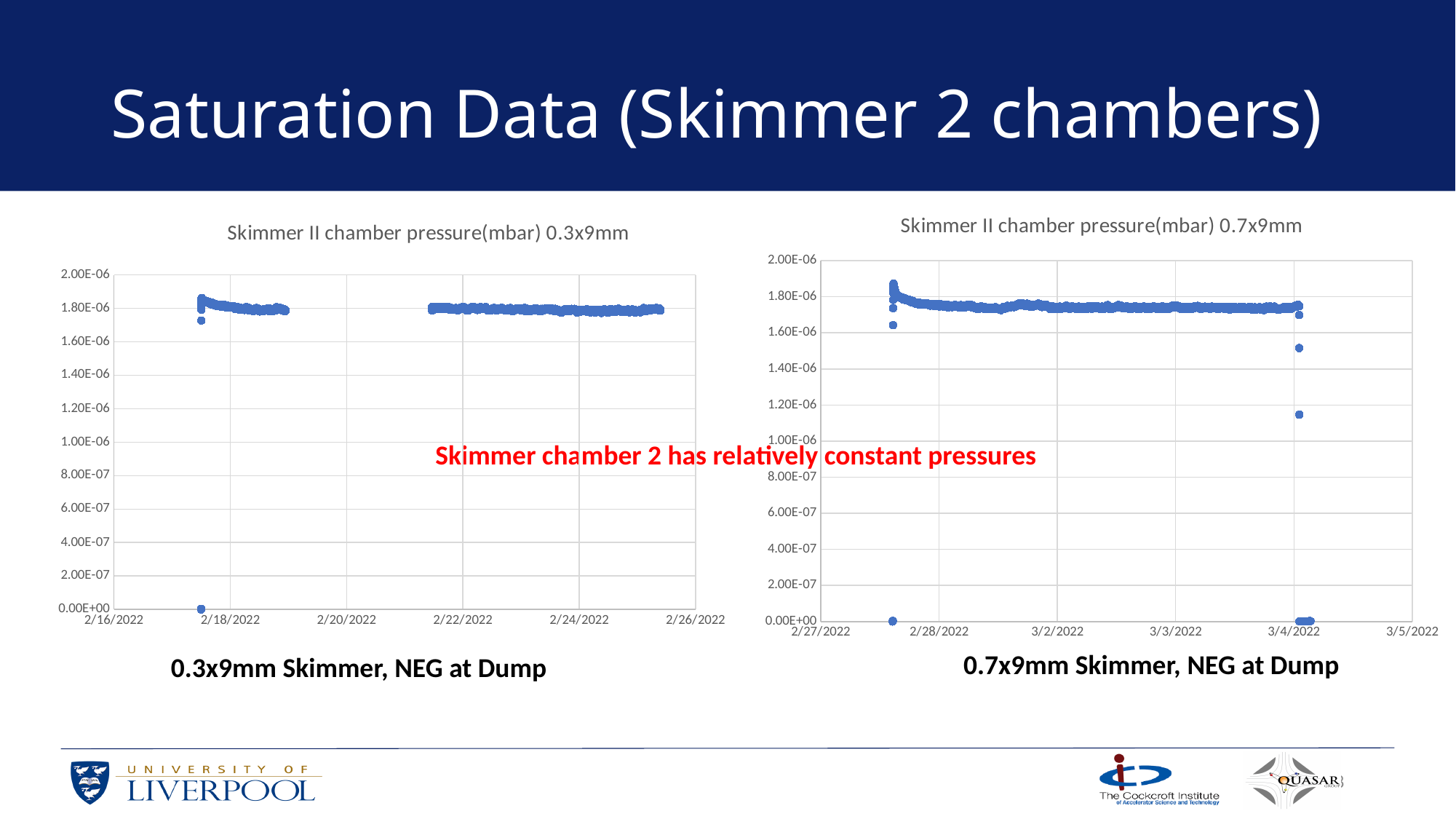
What is the first date label on the x axis of the right chart (0.7x9mm)? 2/27/2022 In the right chart (0.7x9mm), are the pressure values plotted around 3/2/2022 greater or less than 1.60E-06? greater What is the last date label on the x axis of the left chart (0.3x9mm)? 2/26/2022 In the left chart (0.3x9mm), what is the highest value shown on the y axis? 2.00E-06 How many charts are shown on the slide? 2 In the right chart (0.7x9mm), is the isolated point plotted near 3/4/2022 between 1.00E-06 and 1.20E-06 greater or less than 1.00E-06? greater In the right chart (0.7x9mm), is the isolated point plotted just above 1.40E-06 near 3/4/2022 greater or less than 1.40E-06? greater What is the title of the right chart? Skimmer II chamber pressure(mbar) 0.7x9mm In the left chart (0.3x9mm), do the pressure values rise, fall, or stay roughly constant across the dates shown? Roughly constant What kind of chart is the left chart, 'Skimmer II chamber pressure(mbar) 0.3x9mm'? Scatter chart